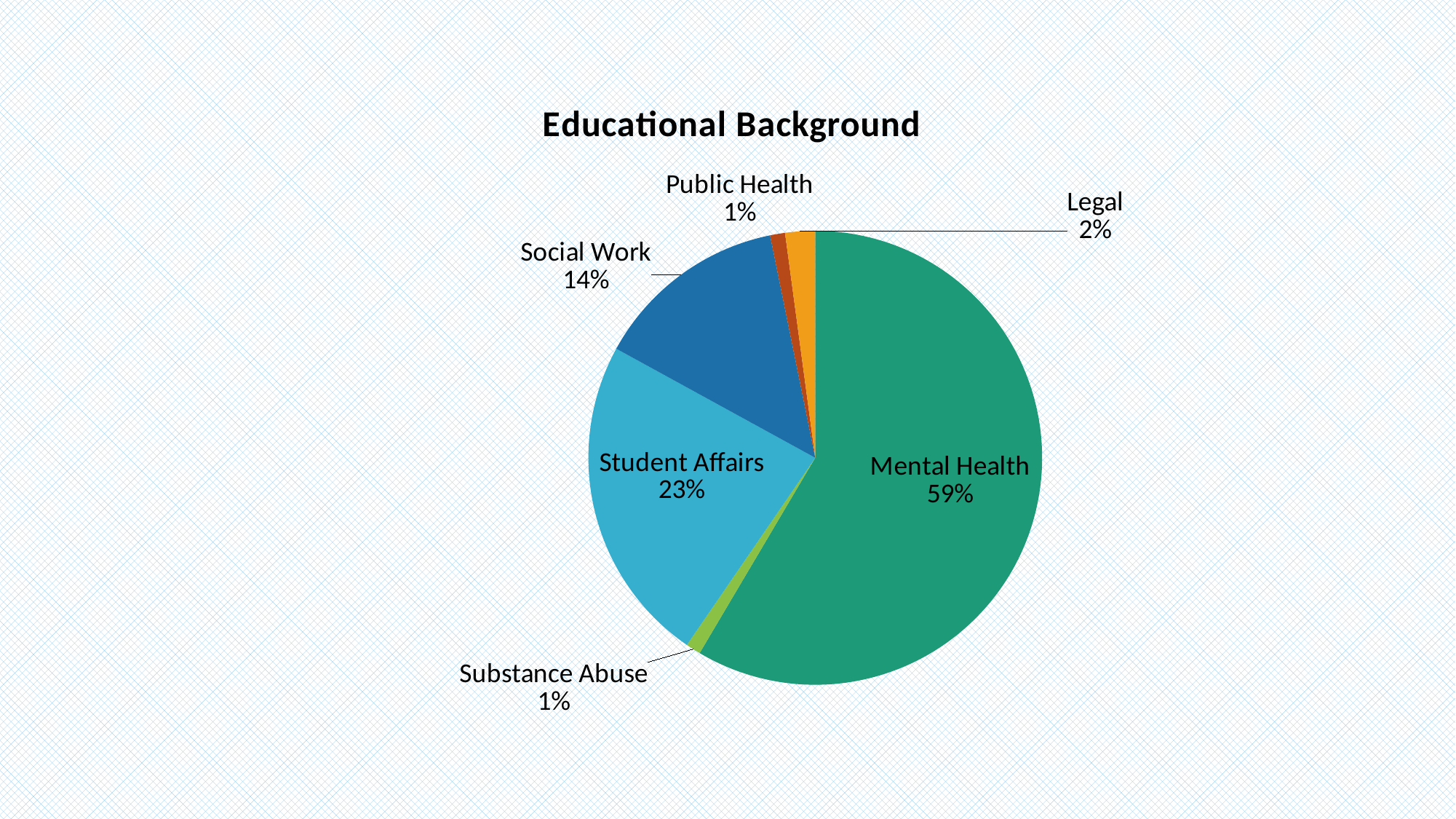
Which two categories each have a share of 1%? Public Health and Substance Abuse What is the value shown for Student Affairs? 23% How many categories are shown in the pie chart? 6 What share of the pie does Mental Health represent? 59% What type of chart is shown on the slide? pie chart What is the title of the chart? Educational Background What is the value shown for Social Work? 14% What is the difference between the Student Affairs and Social Work shares? 9% What is the value shown for Legal? 2% What is the difference between the Mental Health and Student Affairs shares? 36% Which category has the largest slice of the pie? Mental Health Which is larger, the share for Social Work or the share for Student Affairs? Student Affairs